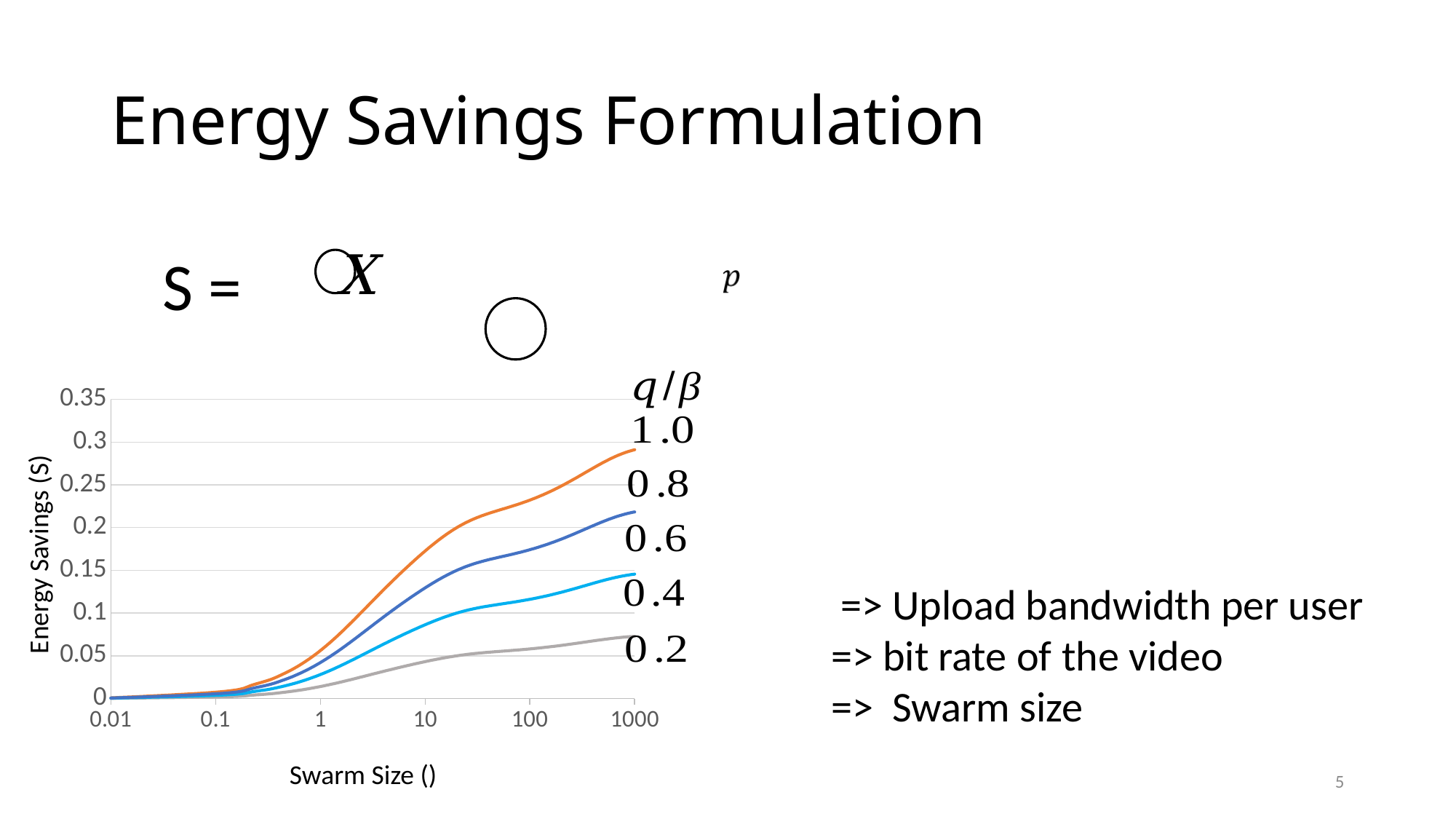
What is the title of the horizontal axis of the chart? Swarm Size () Is the value of the dark blue line at a swarm size of 1000 greater or less than 0.15? greater Do the energy savings values rise or fall as swarm size increases along the x axis? rise Which coloured line has the highest energy savings at a swarm size of 1000? orange What kind of chart is shown on the slide? line chart Which coloured line has the lowest energy savings at a swarm size of 1000? gray What is the title of the vertical axis of the chart? Energy Savings (S) Is the value of the gray line at a swarm size of 1000 greater or less than 0.1? less At a swarm size of 10, which line has the larger value, the orange line or the dark blue line? orange Is the value of the orange line at a swarm size of 1000 greater or less than 0.25? greater